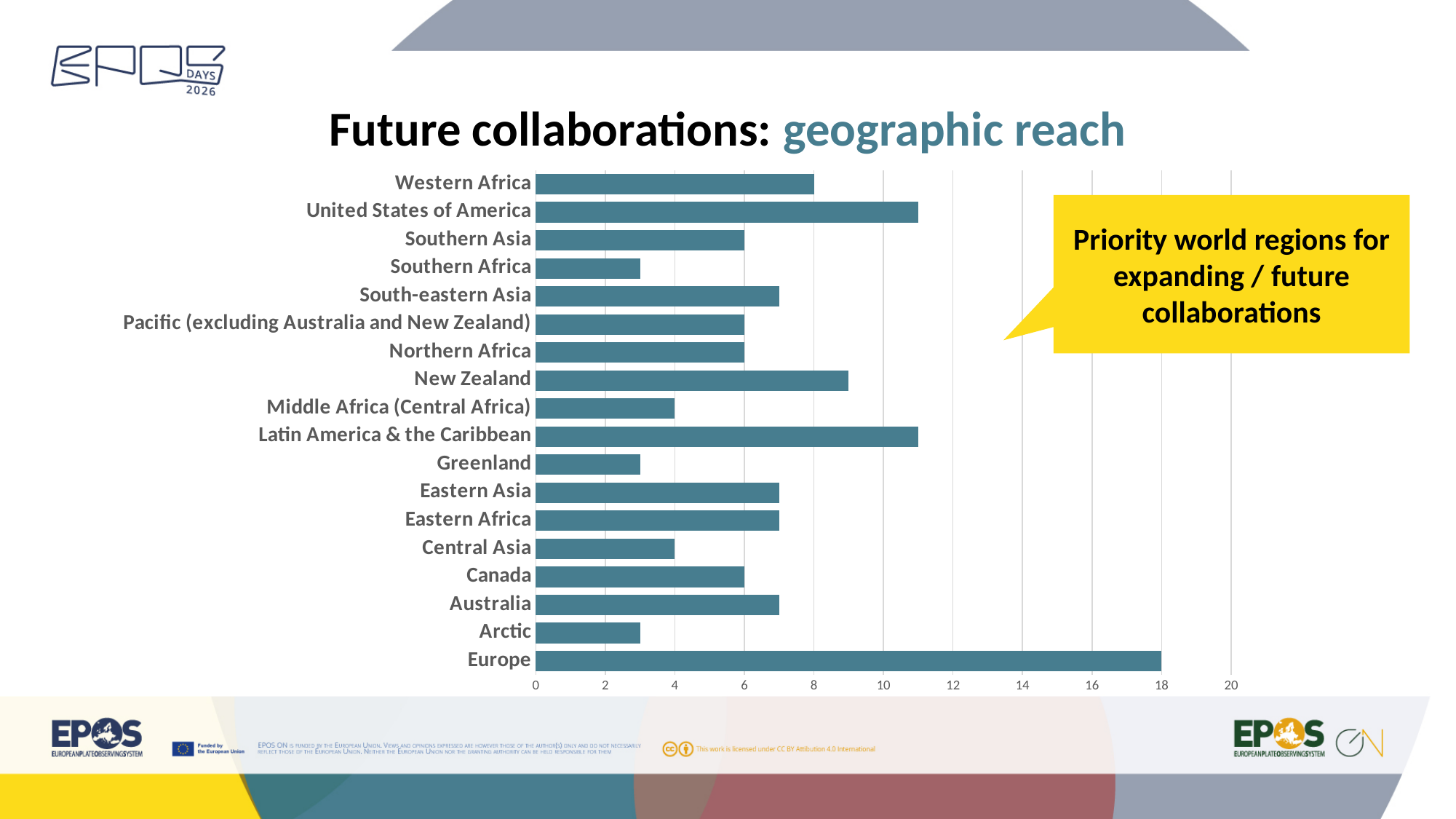
What does the yellow callout box on the slide say? Priority world regions for expanding / future collaborations What is the value for Europe? 18 What type of chart is shown on the slide? Bar chart Is the value for United States of America greater or less than 10? greater How many regions are listed on the chart? 18 What is the value for Western Africa? 8 What is the value for Central Asia? 4 What is the value for Canada? 6 Which has a larger value, Western Africa or Middle Africa (Central Africa)? Western Africa What is the difference between the values for Europe and Western Africa? 10 Is the value for Southern Africa greater or less than 4? less Which region has the highest value on the chart? Europe